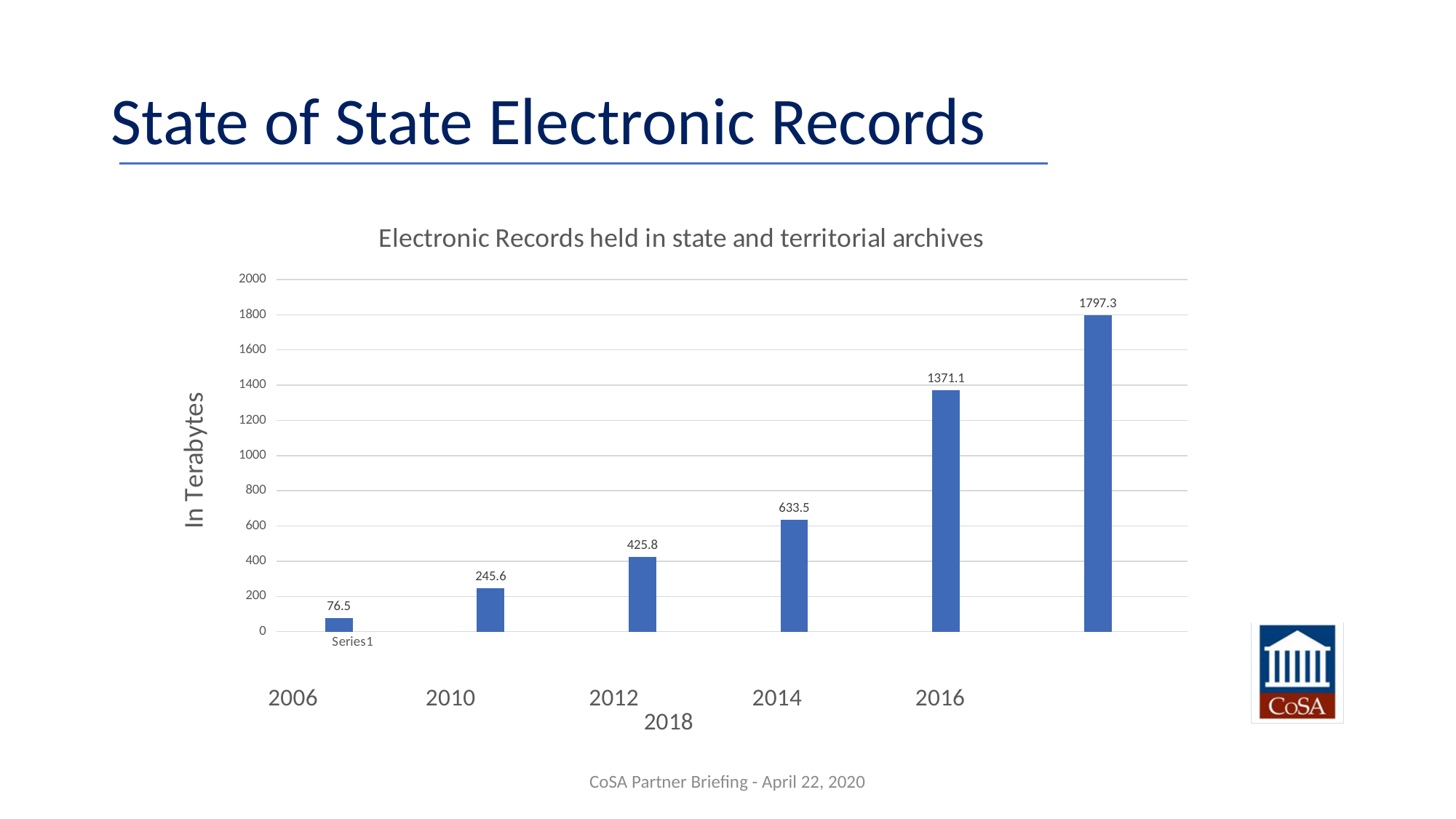
Is the value for 2016 greater or less than 1200? greater What is the value for 2006 in the chart? 76.5 What is the difference between the values for 2018 and 2016? 426.2 Do the values rise or fall from 2006 to 2018? Rise What kind of chart is shown on the slide? Bar chart What is the value for 2014 in the chart? 633.5 How many bars are shown in the chart? 6 Which is larger, the value for 2012 or the value for 2014? 2014 Which year has the lowest value in the chart? 2006 What is the difference between the values for 2010 and 2006? 169.1 What is the value for 2018 in the chart? 1797.3 Which year has the highest value in the chart? 2018